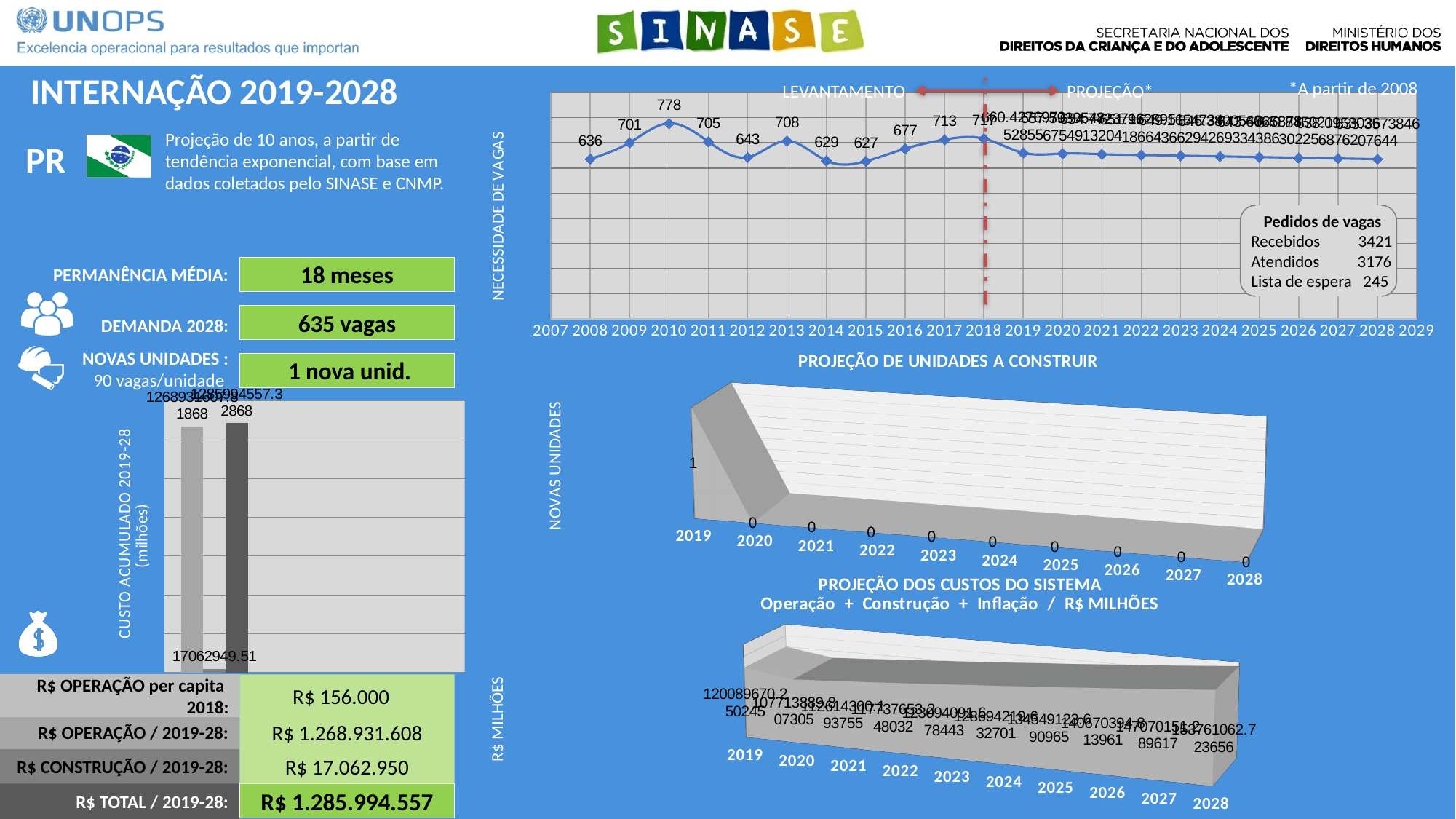
In the top line chart (NECESSIDADE DE VAGAS), what is the difference between the values for 2017 and 2016? 36 In the top line chart (NECESSIDADE DE VAGAS), what is the value for 2008? 636 In the top line chart (NECESSIDADE DE VAGAS), what is the value for 2010? 778 In the top line chart (NECESSIDADE DE VAGAS), which year has the highest value? 2010 In the top line chart (NECESSIDADE DE VAGAS), which is larger, the value for 2013 or the value for 2011? 2013 What kind of chart is the top right chart labelled NECESSIDADE DE VAGAS? line chart How many years are shown on the x axis of the chart PROJEÇÃO DE UNIDADES A CONSTRUIR? 10 What kind of chart is PROJEÇÃO DOS CUSTOS DO SISTEMA? area chart In the chart PROJEÇÃO DE UNIDADES A CONSTRUIR, what is the value for 2025? 0 In the top line chart (NECESSIDADE DE VAGAS), what is the difference between the values for 2010 and 2008? 142 In the chart PROJEÇÃO DE UNIDADES A CONSTRUIR, what is the value for 2019? 1 In the top line chart (NECESSIDADE DE VAGAS), what is the value for 2015? 627